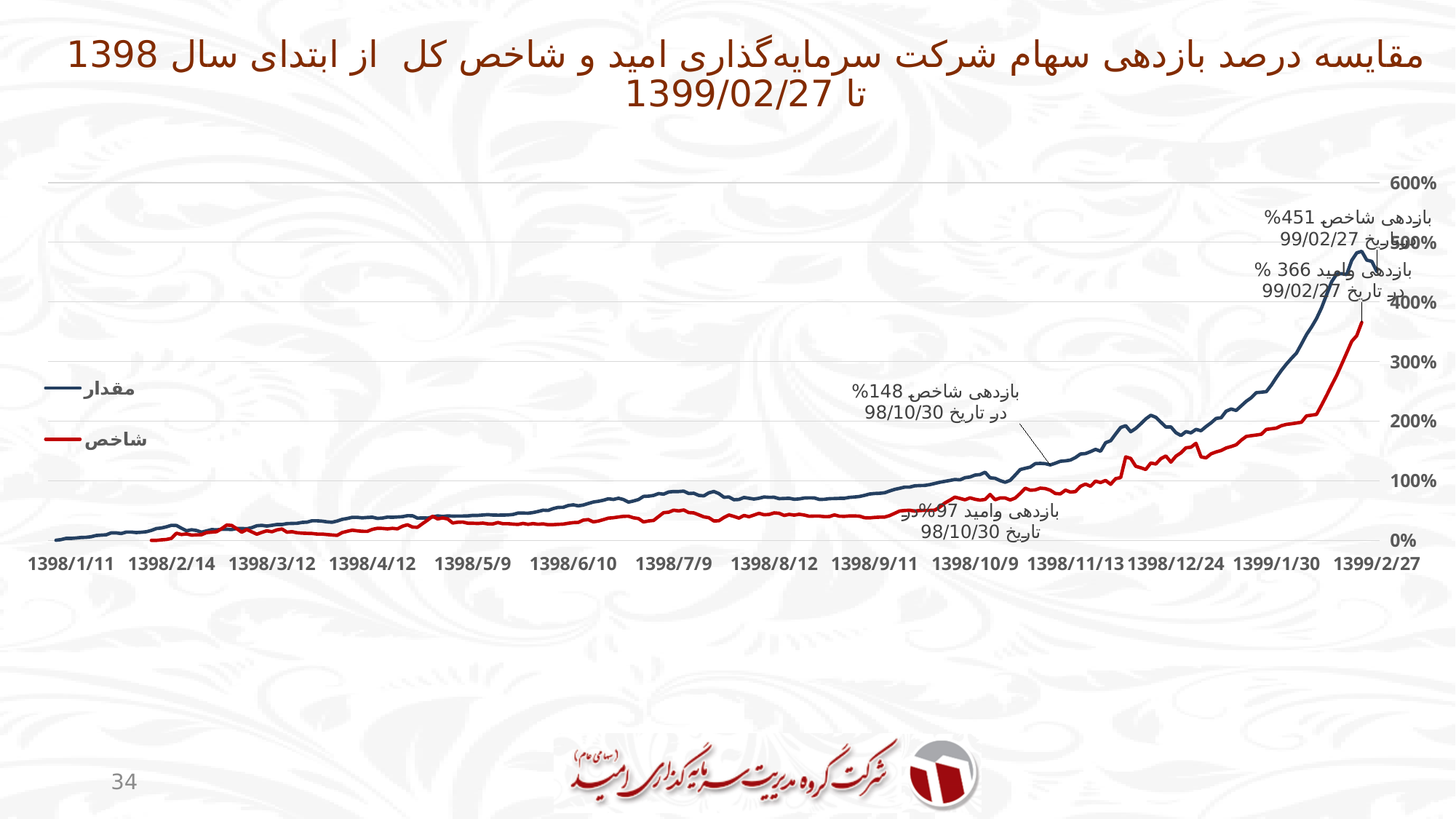
According to the annotation, what is the بازدهی وامید on 98/10/30? 97% According to the annotation, what is the بازدهی شاخص on 99/02/27? 451% What is the difference between the annotated بازدهی شاخص (148%) and بازدهی وامید (97%) on 98/10/30? 51% According to the annotation, what is the بازدهی وامید on 99/02/27? 366% At 1399/2/27, which line is higher: the dark blue مقدار line or the red شاخص line? مقدار What is the difference between the annotated بازدهی شاخص (451%) and بازدهی وامید (366%) on 99/02/27? 85% Is the value of the dark blue مقدار line at 1399/2/27 greater or less than 400%? greater How many series does the legend list? 2 Do the plotted lines generally rise or fall from 1398/1/11 to 1399/2/27? rise According to the annotation, what is the بازدهی شاخص on 98/10/30? 148% What are the two legend entries of the chart? مقدار and شاخص What kind of chart is shown on the slide? line chart